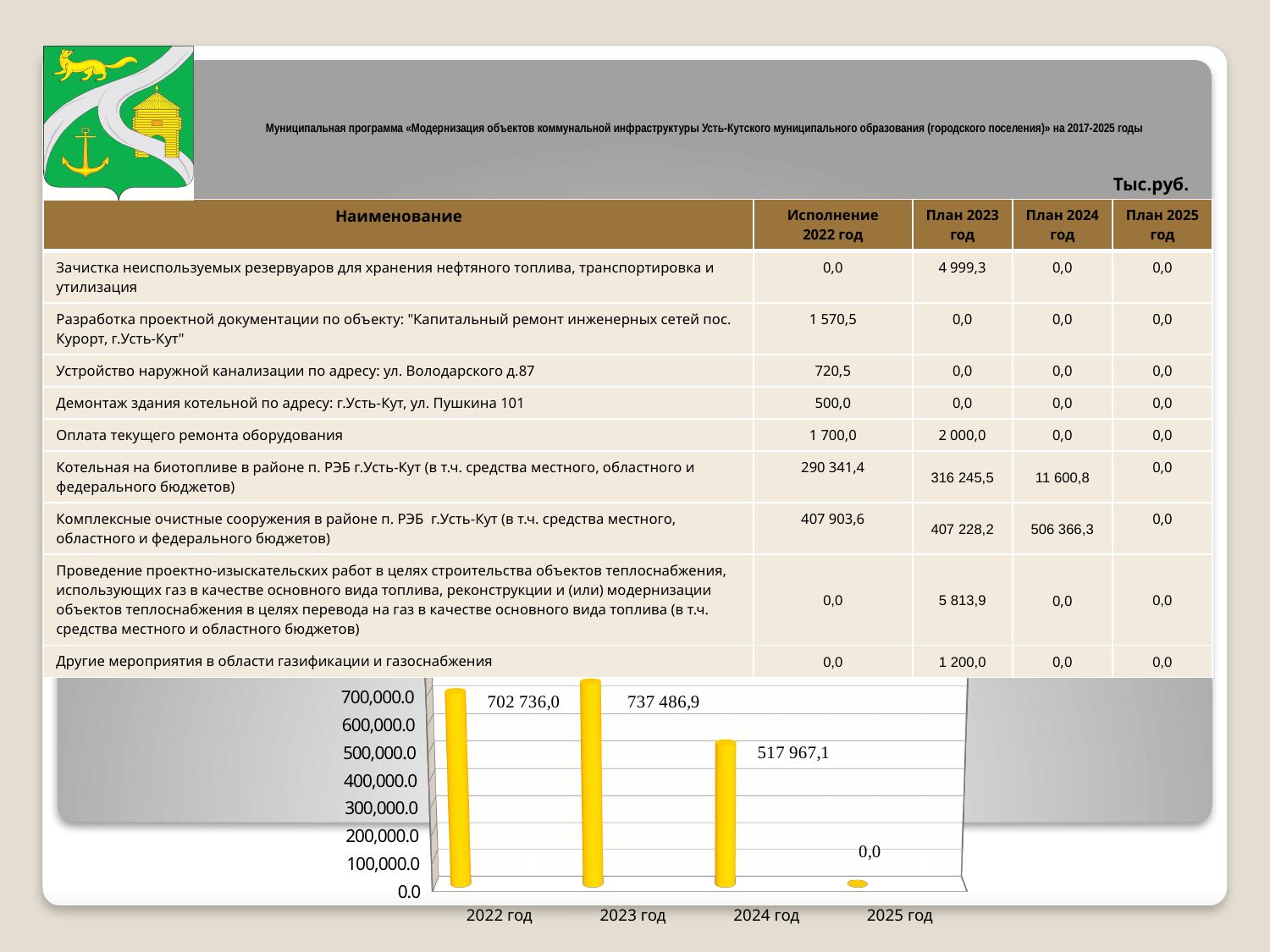
What is the value shown for 2022 год in the bar chart? 702 736,0 How many years are shown on the x axis of the bar chart? 4 Which year has the lowest value in the bar chart? 2025 год What is the value shown for 2025 год in the bar chart? 0,0 What is the value shown for 2024 год in the bar chart? 517 967,1 Is the value for 2022 год in the bar chart greater or less than 600,000.0? greater Which year has the highest value in the bar chart? 2023 год What is the difference between the values for 2023 год and 2022 год in the bar chart? 34 750,9 What is the difference between the values for 2022 год and 2024 год in the bar chart? 184 768,9 What is the value shown for 2023 год in the bar chart? 737 486,9 Which is larger in the bar chart, the value for 2022 год or the value for 2024 год? 2022 год What kind of chart is shown at the bottom of the slide? bar chart